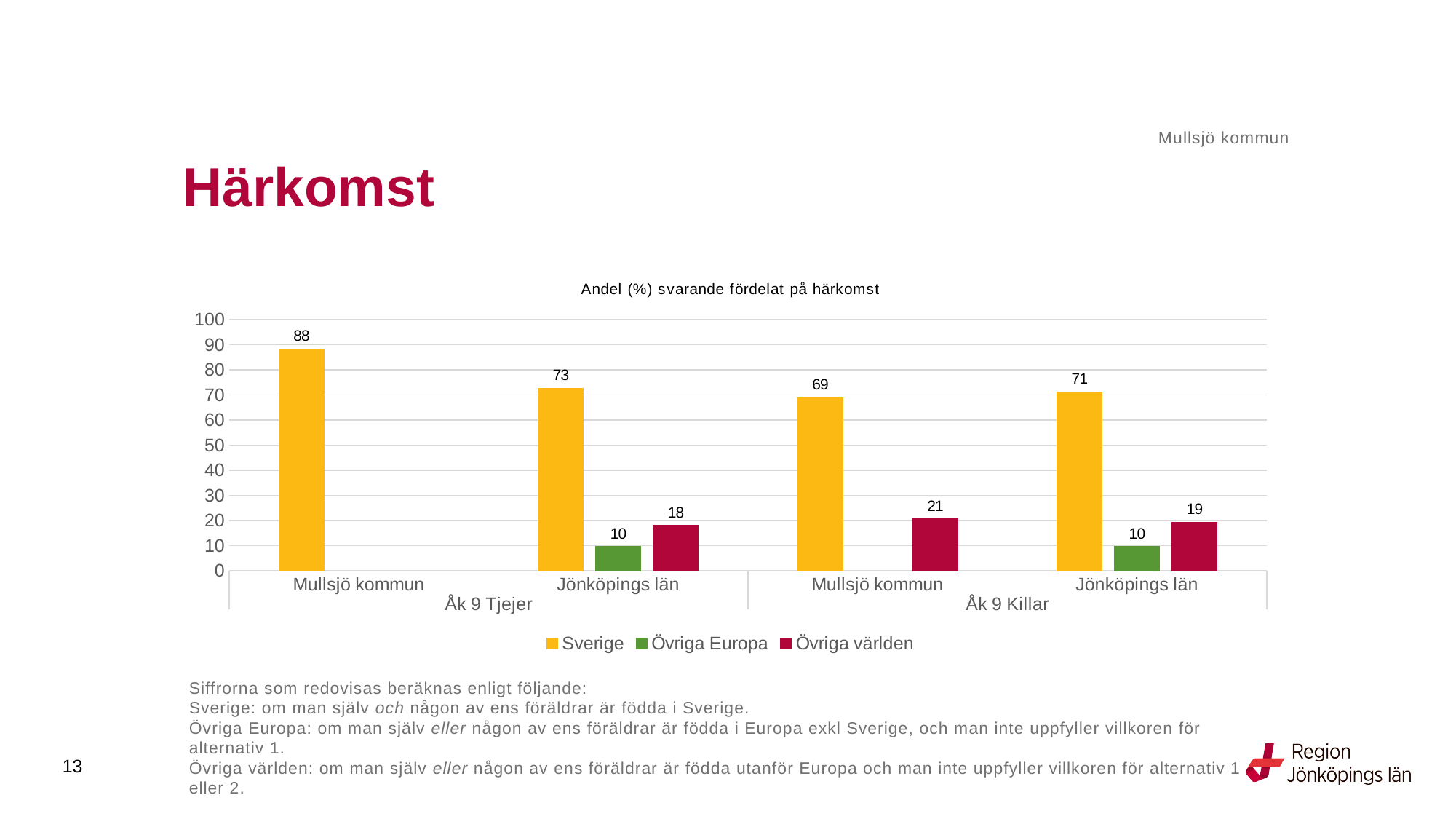
What is the difference between the Övriga världen values for Mullsjö kommun and Jönköpings län among Åk 9 Killar? 2 What is the difference between the Sverige value for Mullsjö kommun and for Jönköpings län among Åk 9 Tjejer? 15 What kind of chart is shown on the slide? Bar chart What is the value for Sverige for Mullsjö kommun among Åk 9 Tjejer? 88 What is the title of the chart? Andel (%) svarande fördelat på härkomst Which group has the highest Sverige value? Mullsjö kommun, Åk 9 Tjejer Which is larger: the Sverige value for Mullsjö kommun or for Jönköpings län among Åk 9 Killar? Jönköpings län How many series does the legend list? 3 What is the value for Övriga världen for Jönköpings län among Åk 9 Tjejer? 18 What is the value for Övriga Europa for Jönköpings län among Åk 9 Killar? 10 What is the value for Övriga världen for Mullsjö kommun among Åk 9 Killar? 21 What is the value for Sverige for Mullsjö kommun among Åk 9 Killar? 69